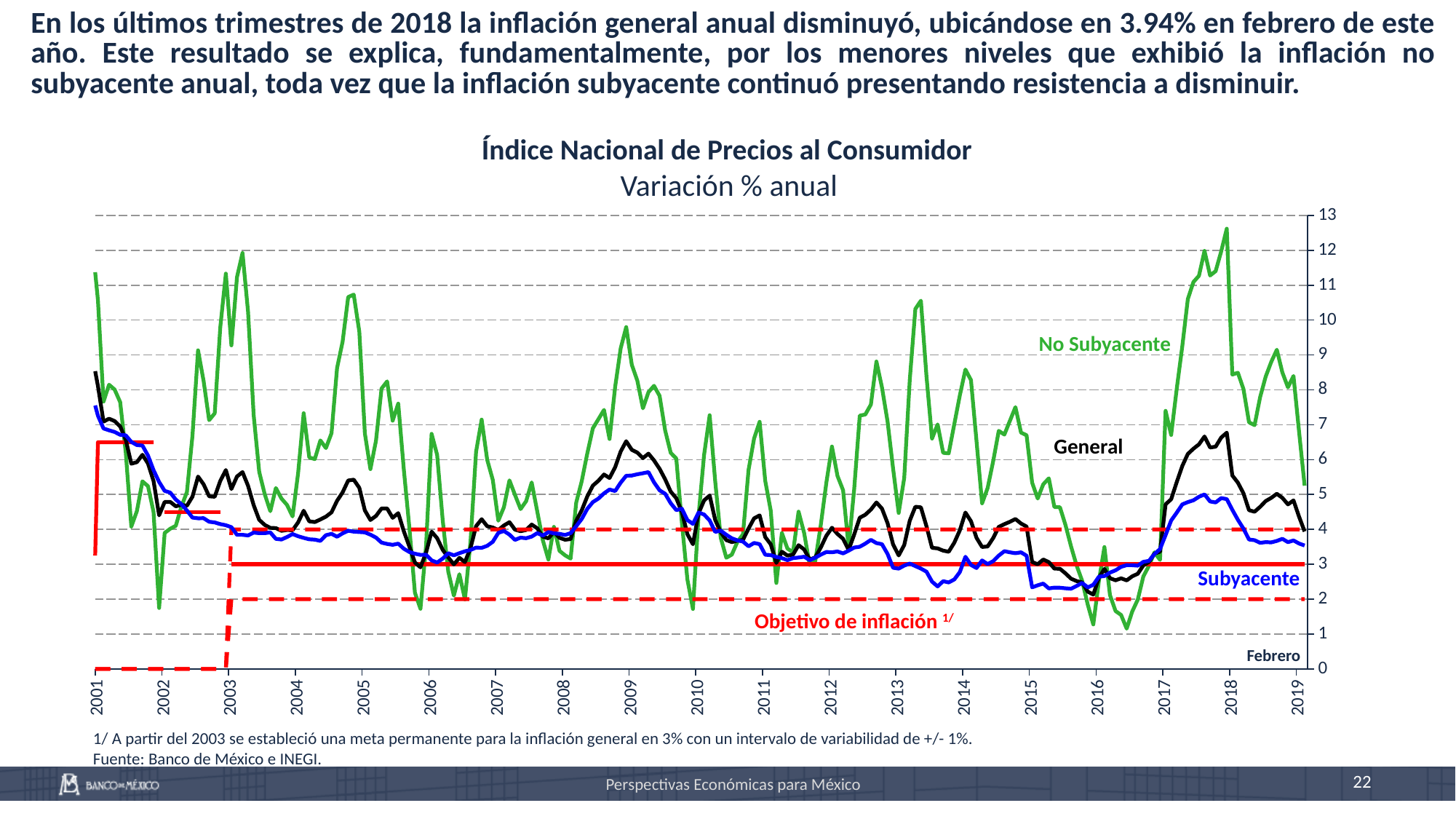
Is the peak value of No Subyacente around 2018 greater or less than 12? greater Is the lowest value of No Subyacente around 2016 greater or less than 2? less What kind of chart is shown on the slide? line chart Does the General series rise or fall between 2001 and 2003? fall Is the value of Subyacente at the start of 2001 greater or less than 6? greater How many year labels are shown on the x axis? 19 According to the slide, what was the annual general inflation in February 2019? 3.94% Which series reaches the highest value anywhere on the chart? No Subyacente What is the title of the chart? Índice Nacional de Precios al Consumidor At the 2018 peak, which is larger: No Subyacente or General? No Subyacente Which series is drawn in green? No Subyacente